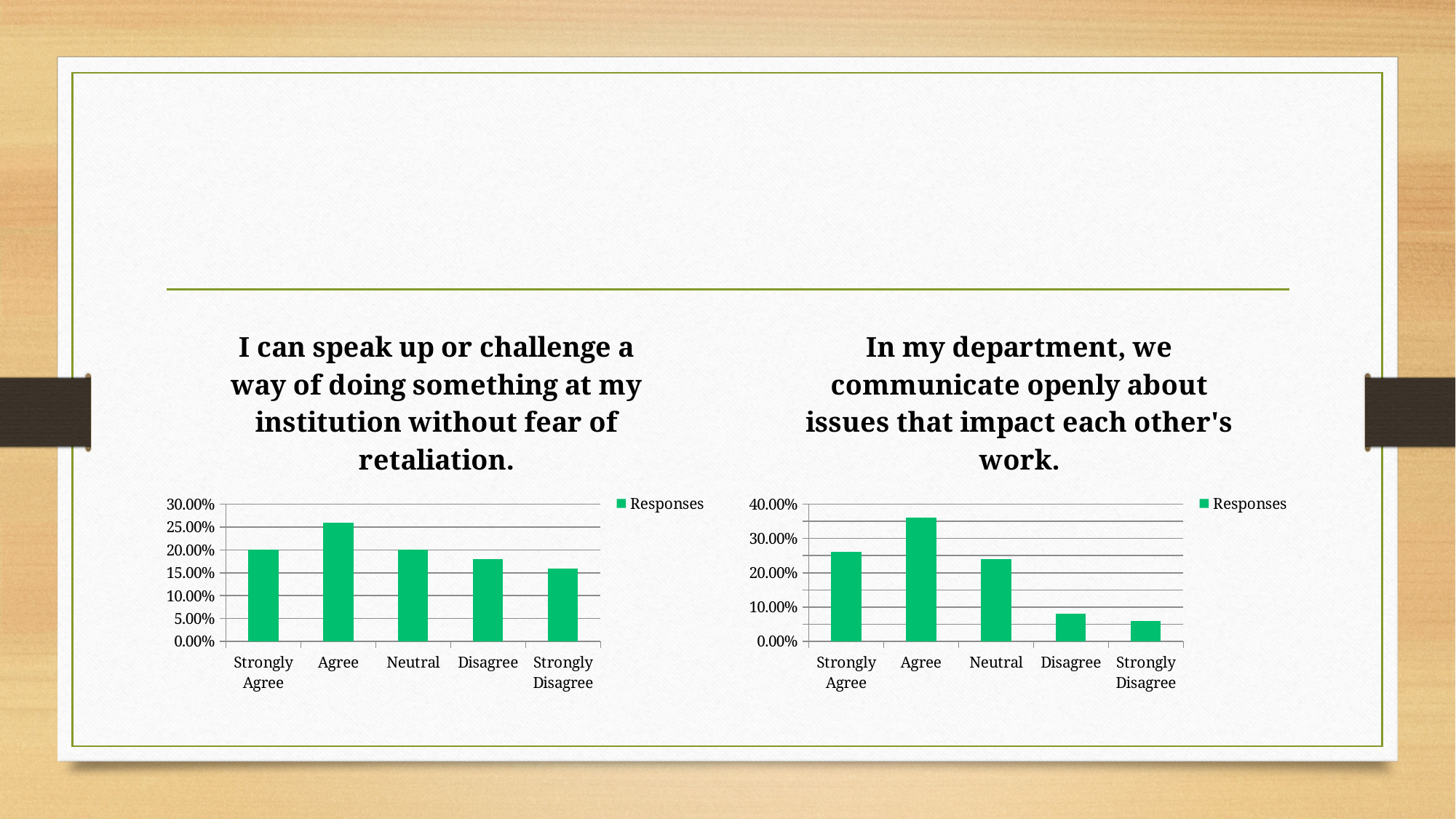
In the right chart ("In my department, we communicate openly..."), which category has the highest value? Agree What type of chart is the left chart titled "I can speak up or challenge a way of doing something at my institution without fear of retaliation."? bar chart In the right chart ("In my department, we communicate openly..."), which category has the lowest value? Strongly Disagree In the left chart ("I can speak up or challenge..."), which category has the lowest value? Strongly Disagree In the right chart ("In my department, we communicate openly..."), is the value for Disagree greater or less than 10.00%? less In the left chart ("I can speak up or challenge..."), is the value for Agree greater or less than 25.00%? greater In the left chart ("I can speak up or challenge..."), which category has the highest value? Agree In the left chart ("I can speak up or challenge..."), is the value for Strongly Disagree greater or less than 20.00%? less How many series does the legend of the right chart ("In my department, we communicate openly...") list? 1 In the right chart ("In my department, we communicate openly..."), which is larger, the value for Strongly Agree or the value for Neutral? Strongly Agree How many categories are shown on the x axis of the left chart ("I can speak up or challenge...")? 5